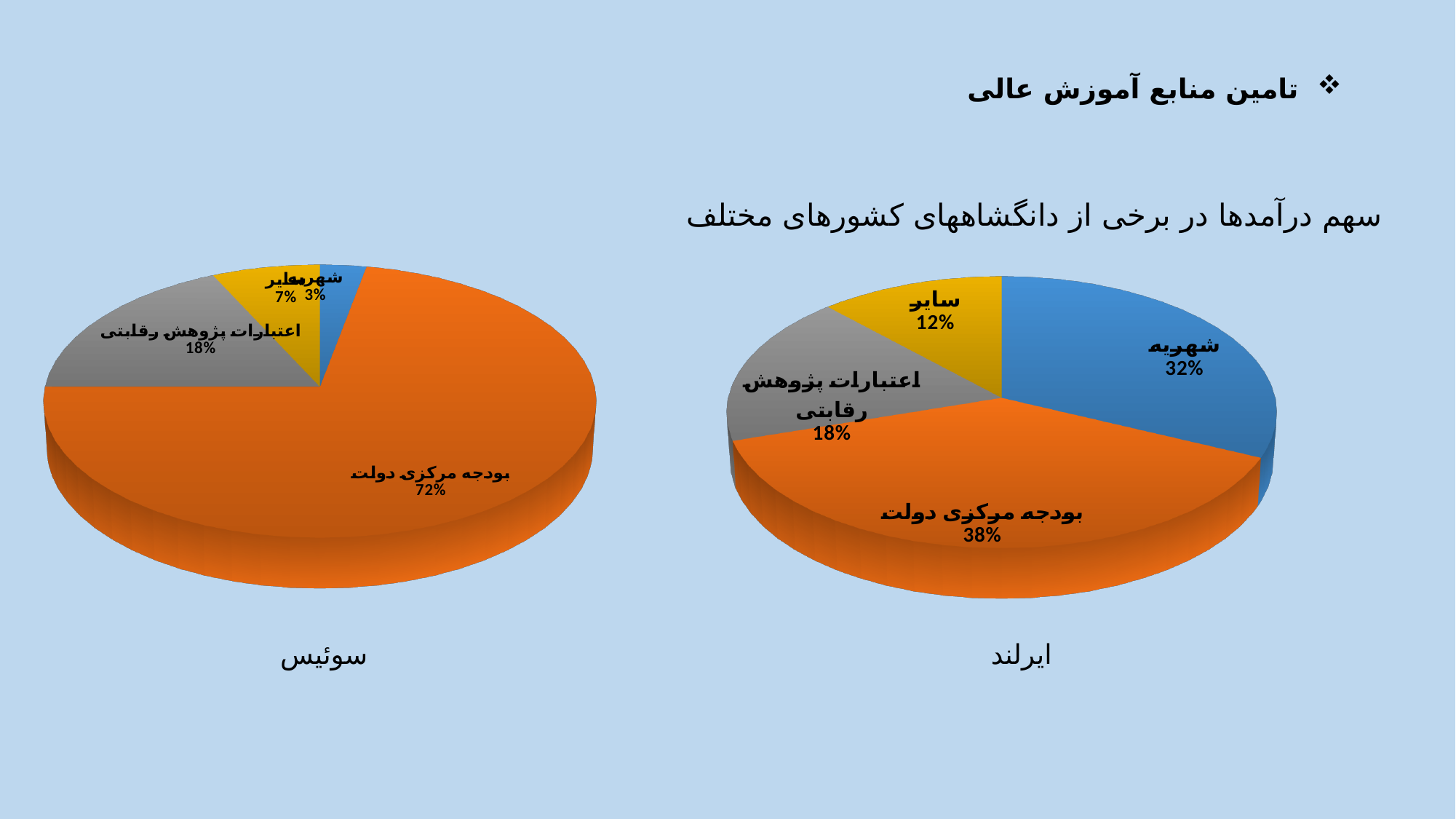
How many slices does the Ireland (ایرلند) pie chart have? 4 In the Ireland (ایرلند) pie chart, what share is shown for شهریه? 32% What type of chart is used for the Switzerland (سوئیس) data? Pie chart In the Ireland (ایرلند) pie chart, what share is shown for اعتبارات پژوهش رقابتی? 18% In the Ireland (ایرلند) pie chart, what is the difference between the shares of بودجه مرکزی دولت and شهریه? 6% In the Ireland (ایرلند) pie chart, what share is shown for سایر? 12% In the Ireland (ایرلند) pie chart, which category has the smallest share? سایر Which chart shows a larger share for بودجه مرکزی دولت, Switzerland (سوئیس) or Ireland (ایرلند)? سوئیس In the Switzerland (سوئیس) pie chart, what share is shown for بودجه مرکزی دولت? 72% In the Switzerland (سوئیس) pie chart, what share is shown for اعتبارات پژوهش رقابتی? 18% In the Ireland (ایرلند) pie chart, what share is shown for بودجه مرکزی دولت? 38% In the Ireland (ایرلند) pie chart, which category has the largest share? بودجه مرکزی دولت